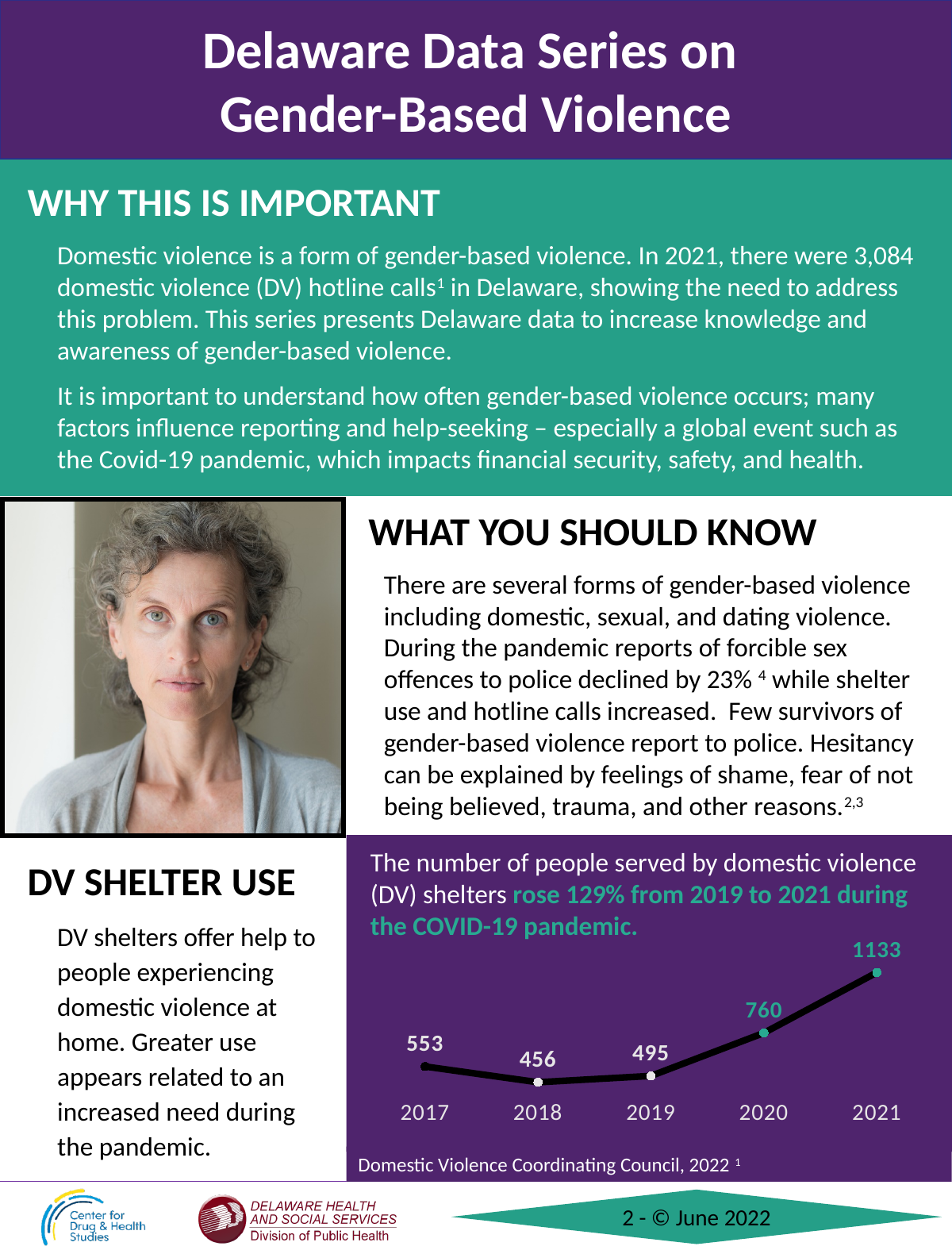
Which year had more people served by DV shelters, 2017 or 2019? 2017 What was the number of people served by DV shelters in 2017? 553 What was the number of people served by DV shelters in 2020? 760 How many years are plotted in the DV shelter use chart? 5 What is the difference between the number of people served by DV shelters in 2021 and in 2019? 638 Did the number of people served by DV shelters rise or fall from 2019 to 2021? Rise What kind of chart is used to show the number of people served by DV shelters? Line chart Which year had the lowest number of people served by DV shelters? 2018 What was the number of people served by DV shelters in 2018? 456 Which year had the highest number of people served by DV shelters? 2021 What was the number of people served by DV shelters in 2019? 495 What was the number of people served by DV shelters in 2021? 1133